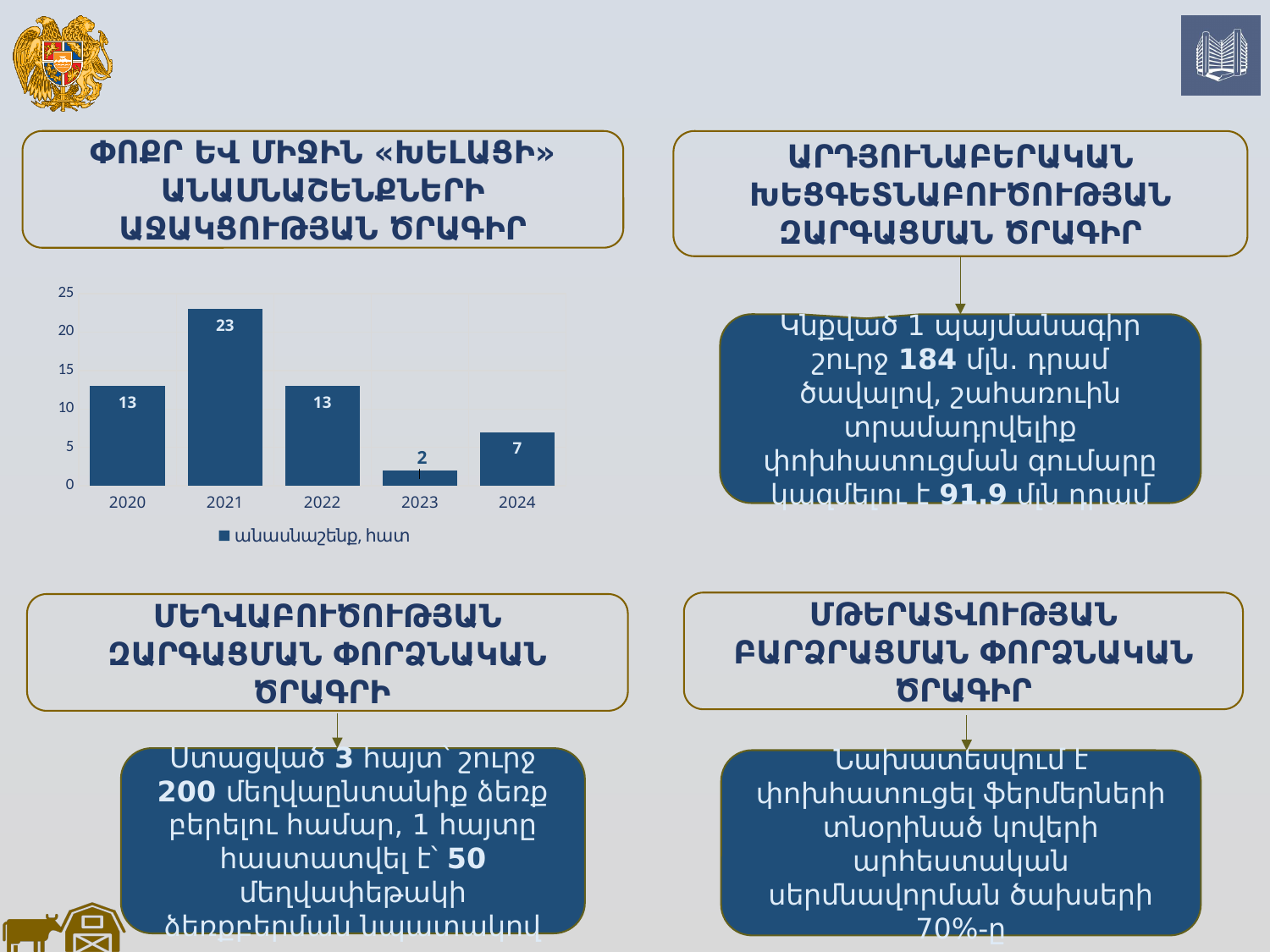
What is the difference between the values for 2021 and 2022 in the bar chart? 10 What is the difference between the values for 2024 and 2023 in the bar chart? 5 Is the value for 2021 in the bar chart greater or less than 20? greater Which year has the highest value in the bar chart? 2021 How many years are shown on the x axis of the bar chart? 5 Which year has the lowest value in the bar chart? 2023 What kind of chart is shown on the slide? bar chart What is the value for 2021 in the bar chart? 23 Which is larger in the bar chart, the value for 2020 or the value for 2024? 2020 What is the legend entry of the bar chart? անասնաշենք, հատ What is the value for 2024 in the bar chart? 7 What is the value for 2023 in the bar chart? 2